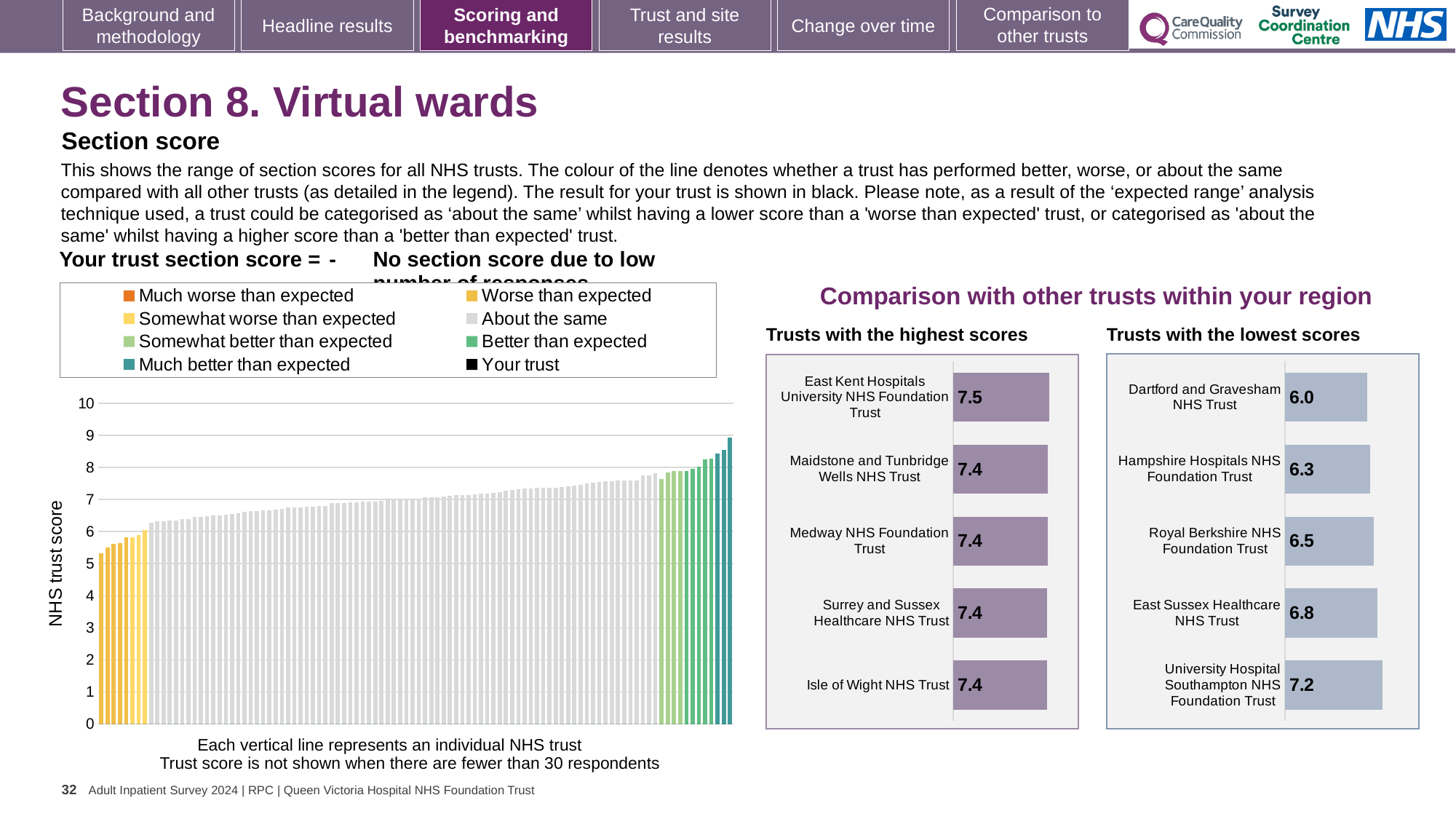
In the large chart on the left, is the value of the tallest bar greater or less than 8? greater In the 'Trusts with the lowest scores' chart, which has the higher score: Royal Berkshire NHS Foundation Trust or East Sussex Healthcare NHS Trust? East Sussex Healthcare NHS Trust In the 'Trusts with the highest scores' chart, which trust has the highest score? East Kent Hospitals University NHS Foundation Trust In the 'Trusts with the lowest scores' chart, what is the difference between the scores of University Hospital Southampton NHS Foundation Trust and Dartford and Gravesham NHS Trust? 1.2 In the 'Trusts with the highest scores' chart, what is the score for East Kent Hospitals University NHS Foundation Trust? 7.5 In the 'Trusts with the lowest scores' chart, which trust has the lowest score? Dartford and Gravesham NHS Trust How many entries does the legend of the large chart on the left list? 8 In the 'Trusts with the lowest scores' chart, what is the score for Hampshire Hospitals NHS Foundation Trust? 6.3 In the large chart on the left, do the NHS trust scores rise or fall from left to right? Rise How many trusts are shown in the 'Trusts with the highest scores' chart? 5 In the 'Trusts with the lowest scores' chart, what is the score for University Hospital Southampton NHS Foundation Trust? 7.2 What type of chart is the large chart on the left showing NHS trust scores? Bar chart